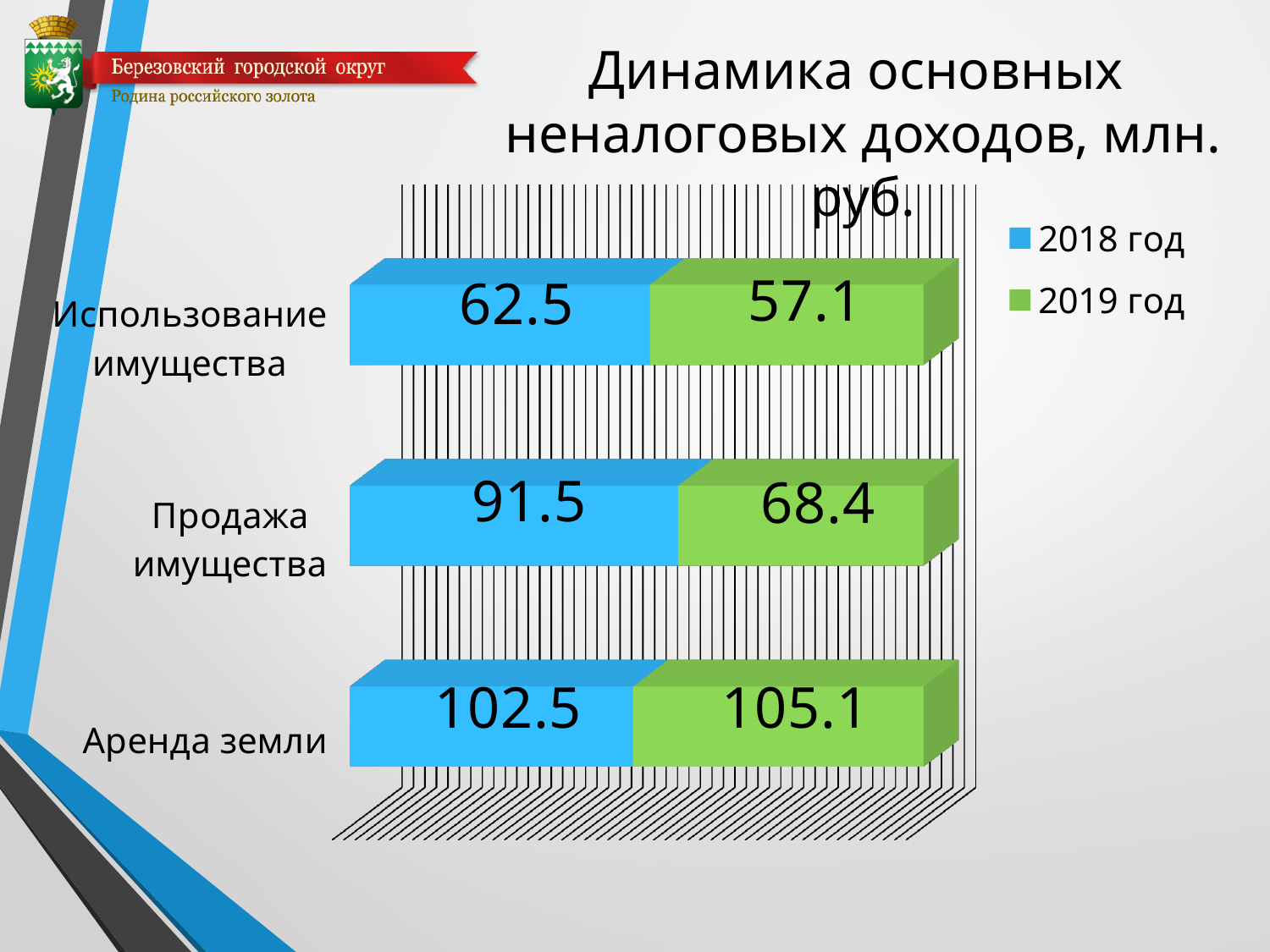
What is the difference between the 2018 год and 2019 год values for Продажа имущества? 23.1 What is the value for 2019 год for Использование имущества? 57.1 What is the total of the stacked bar for Использование имущества? 119.6 What is the value for 2018 год for Продажа имущества? 91.5 Which category has the highest value for 2018 год? Аренда земли What is the value for 2019 год for Продажа имущества? 68.4 How many series does the legend list? 2 What kind of chart is shown on the slide? Bar chart What is the value for 2018 год for Аренда земли? 102.5 Which category has the lowest value for 2019 год? Использование имущества Which is larger for Аренда земли: the 2018 год value or the 2019 год value? 2019 год How many categories are shown on the chart? 3